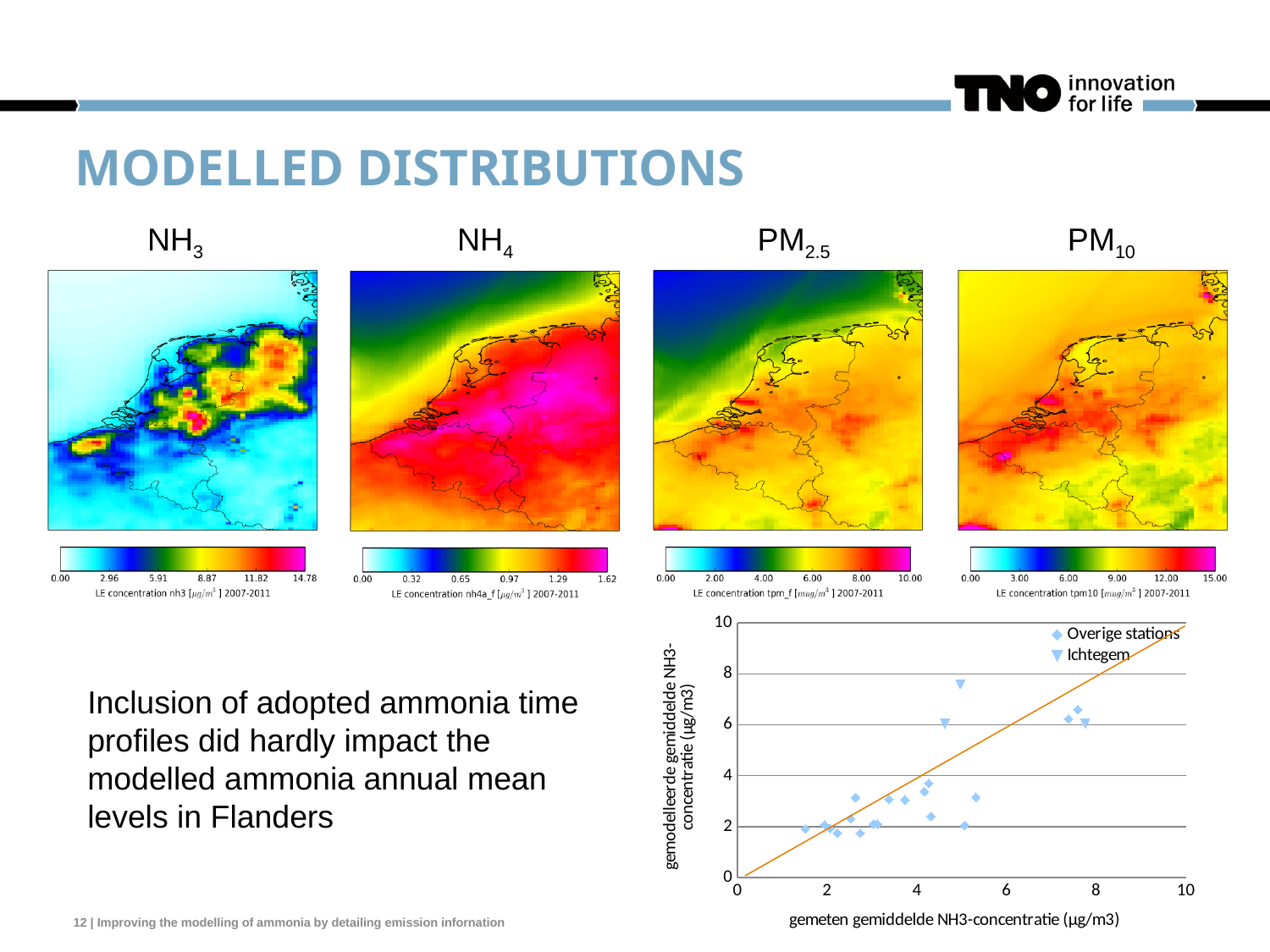
What is the maximum value on the colour scale of the PM10 map? 15.00 What is the x-axis title of the scatter chart at the bottom right? gemeten gemiddelde NH3-concentratie (µg/m3) What are the two legend entries of the scatter chart at the bottom right? Overige stations, Ichtegem What is the maximum value on the colour scale of the NH3 map? 14.78 In the scatter chart at the bottom right, is the lowest modelled value among the Overige stations points greater or less than 4? less In the scatter chart at the bottom right, is the highest modelled value among the Overige stations points greater or less than 6? greater What is the maximum value on the colour scale of the NH4 map? 1.62 What is the maximum value shown on the y axis of the scatter chart at the bottom right? 10 What kind of chart is the chart at the bottom right of the slide? scatter chart Which map has the higher maximum colour-scale value, PM2.5 or PM10? PM10 How many series does the legend of the scatter chart at the bottom right list? 2 How many map panels of modelled distributions are shown on the slide? 4